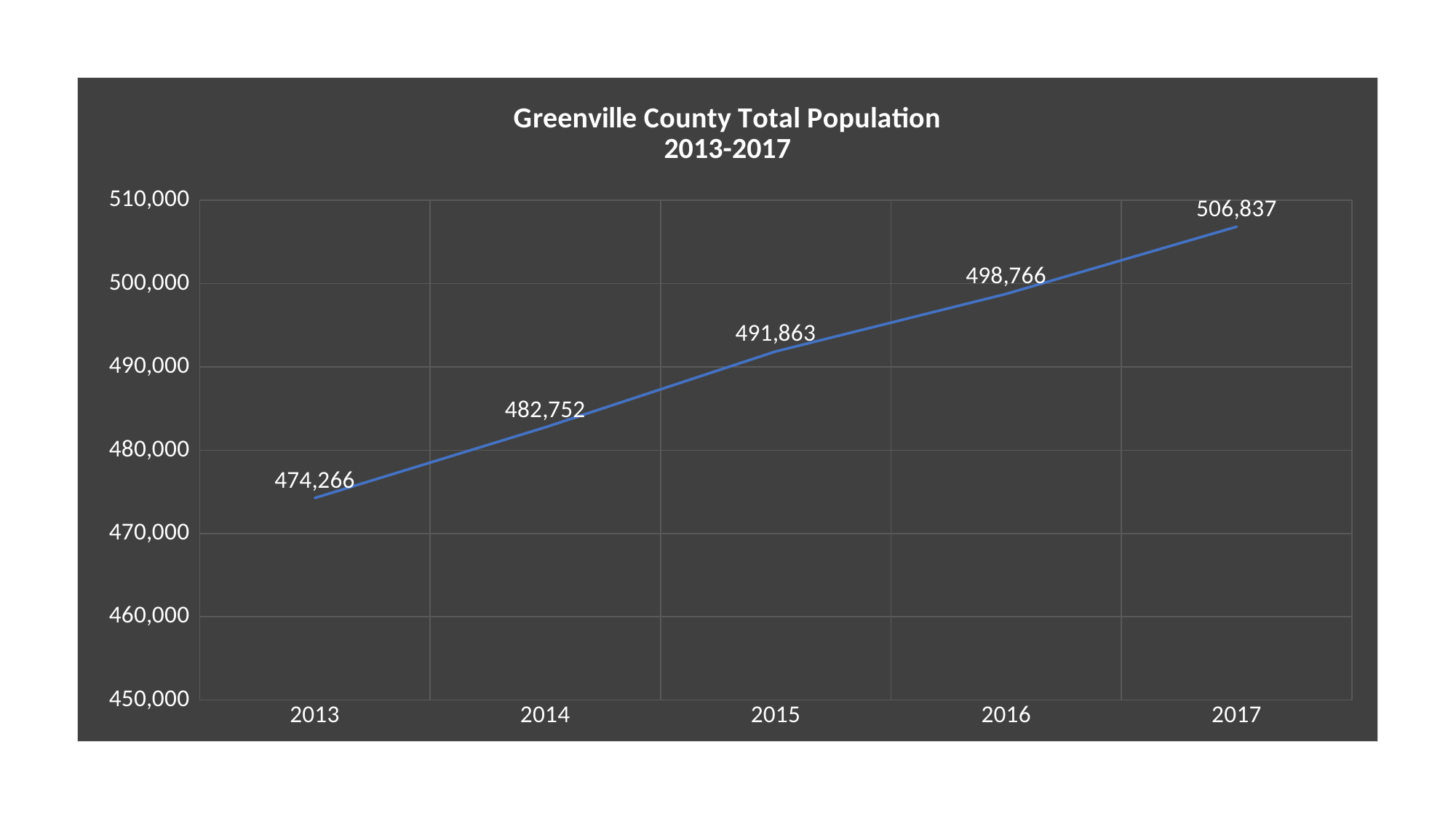
What kind of chart is shown on the slide? line chart What was the total population of Greenville County in 2015? 491,863 Which year had a larger population, 2014 or 2016? 2016 What was the total population of Greenville County in 2013? 474,266 What is the difference in population between 2016 and 2015? 6,903 By how much did the population increase from 2013 to 2017? 32,571 Which year has the highest population value on the chart? 2017 Which year has the lowest population value on the chart? 2013 What was the total population of Greenville County in 2017? 506,837 Does the population rise or fall from 2013 to 2017? rise How many years are plotted on the chart? 5 Is the population value for 2016 greater or less than 500,000? less